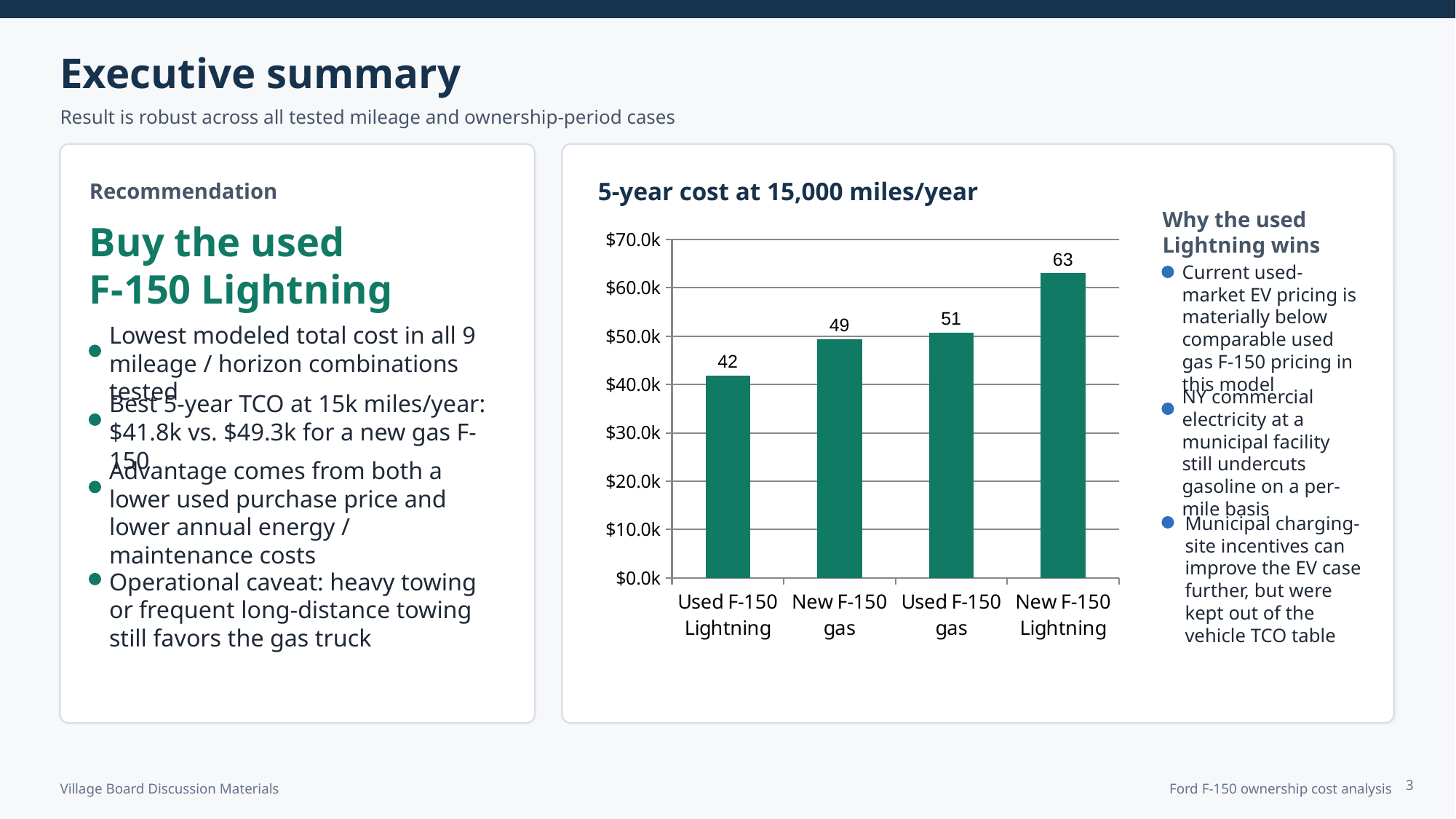
What is the data label on the bar for New F-150 gas? 49 Which category has the highest 5-year cost? New F-150 Lightning How many categories are shown on the x axis of the chart? 4 What is the difference between the data labels for New F-150 Lightning and Used F-150 Lightning? 21 Which has the larger value, New F-150 gas or Used F-150 gas? Used F-150 gas What is the data label on the bar for New F-150 Lightning? 63 Which category has the lowest 5-year cost? Used F-150 Lightning What is the data label on the bar for Used F-150 Lightning? 42 What kind of chart is shown on the slide? bar chart What is the data label on the bar for Used F-150 gas? 51 What is the title of the chart? 5-year cost at 15,000 miles/year Is the value for New F-150 Lightning greater or less than $60.0k? greater